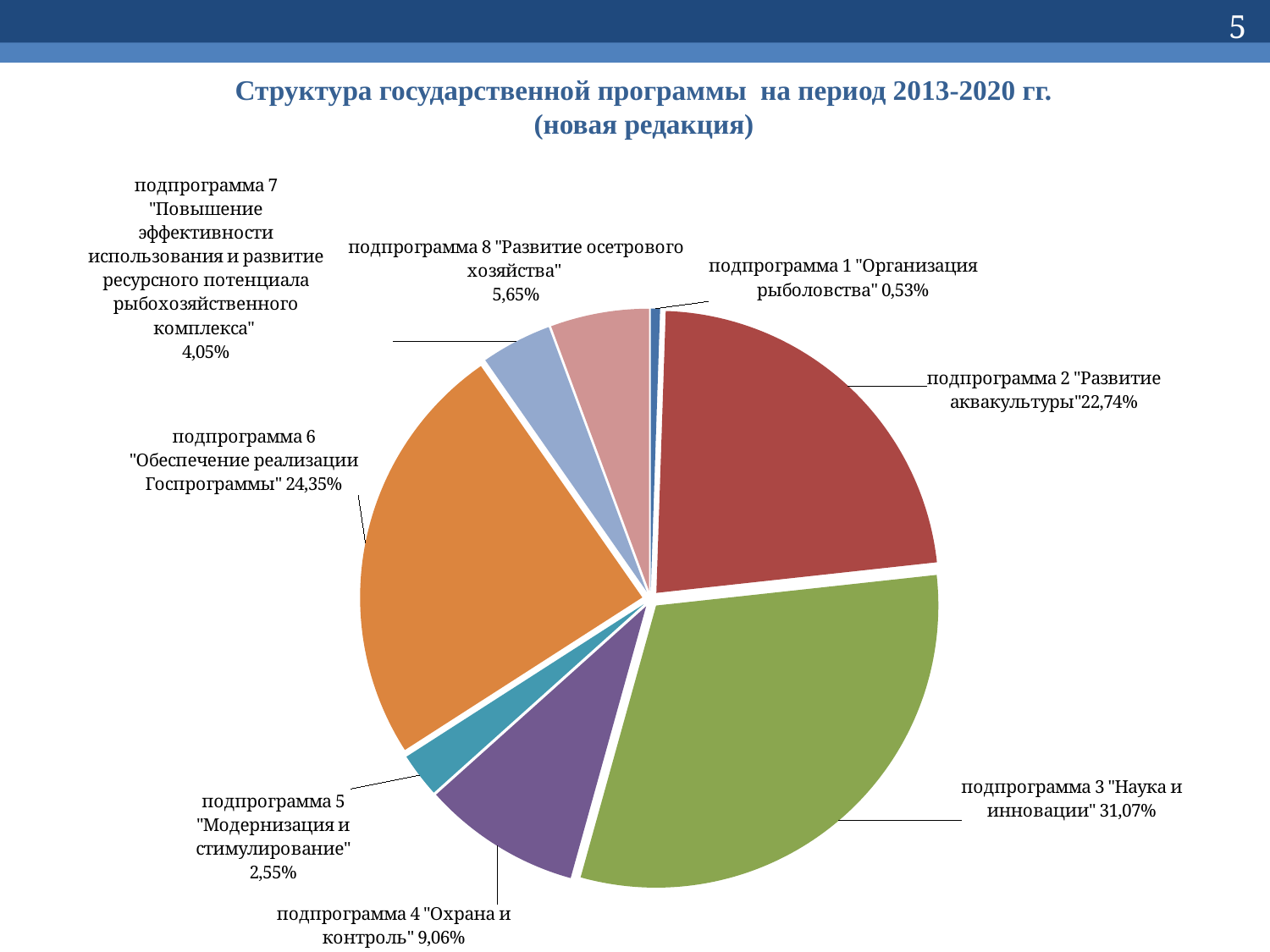
What is the value shown for подпрограмма 8 "Развитие осетрового хозяйства"? 5,65% Which has the larger share: подпрограмма 6 "Обеспечение реализации Госпрограммы" or подпрограмма 2 "Развитие аквакультуры"? подпрограмма 6 "Обеспечение реализации Госпрограммы" Which subprogram has the largest share of the pie? подпрограмма 3 "Наука и инновации" What kind of chart is shown on the slide? pie chart What is the title of the slide above the chart? Структура государственной программы на период 2013-2020 гг. (новая редакция) Which has the larger share: подпрограмма 7 or подпрограмма 5 "Модернизация и стимулирование"? подпрограмма 7 What is the difference in percentage points between подпрограмма 3 "Наука и инновации" and подпрограмма 4 "Охрана и контроль"? 22,01 What is the value shown for подпрограмма 6 "Обеспечение реализации Госпрограммы"? 24,35% How many slices (subprograms) does the pie chart have? 8 What is the value shown for подпрограмма 2 "Развитие аквакультуры"? 22,74% Which subprogram has the smallest share of the pie? подпрограмма 1 "Организация рыболовства" What share of the pie does подпрограмма 3 "Наука и инновации" have? 31,07%